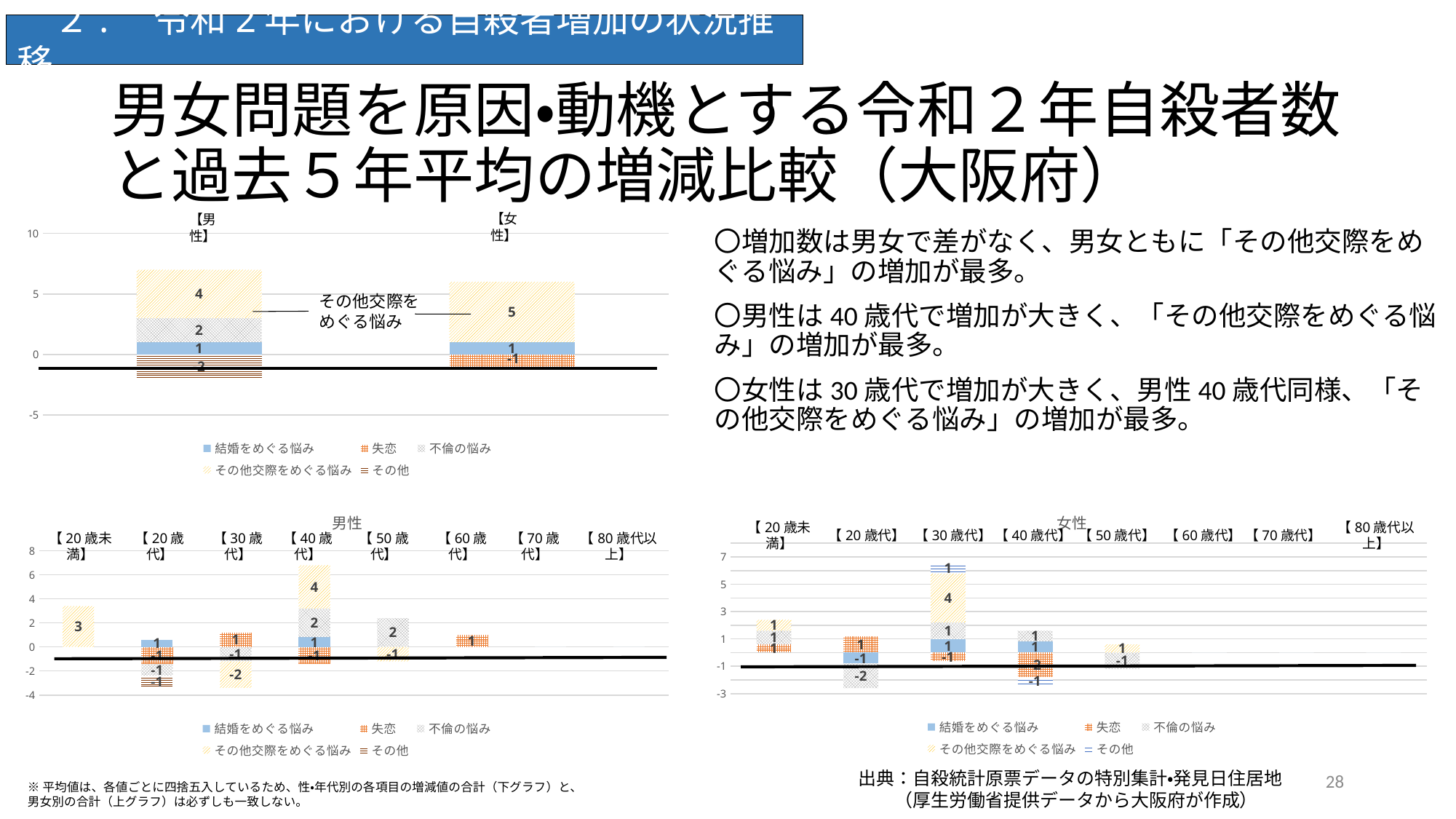
How many series does the legend of the top-left chart list? 5 How many age categories are shown on the x axis of the bottom-right 女性 chart? 8 In the bottom-left 男性 chart, what is the value for その他交際をめぐる悩み for 20歳未満? 3 In the top-left chart, which is larger for その他交際をめぐる悩み: 男性 or 女性? 女性 In the bottom-left 男性 chart, what is the value for その他交際をめぐる悩み for 40歳代? 4 In the top-left chart, what is the value for その他交際をめぐる悩み for 男性? 4 In the top-left chart, what is the difference between the その他交際をめぐる悩み values for 女性 and 男性? 1 In the top-left chart, what is the value for その他交際をめぐる悩み for 女性? 5 In the bottom-right 女性 chart, what is the value for その他交際をめぐる悩み for 30歳代? 4 In the bottom-left 男性 chart, which age group has the tallest positive stacked bar? 40歳代 In the top-left chart, what is the value for 不倫の悩み for 男性? 2 What kind of chart is the bottom-left 男性 chart? Stacked bar chart